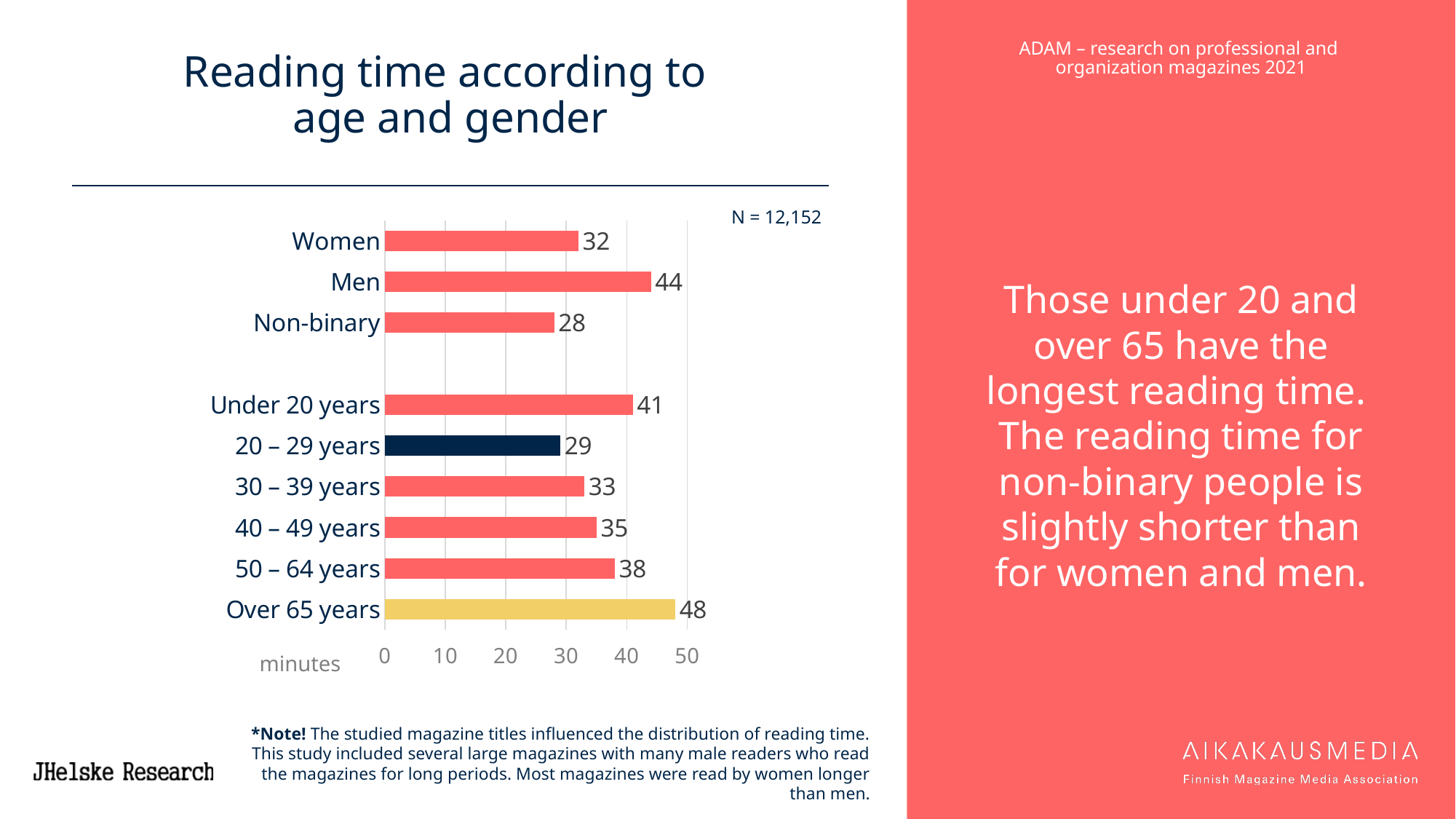
What is the difference in reading time between Men and Women? 12 How many categories are plotted in the chart? 9 What kind of chart is shown on the slide? Bar chart What is the sample size (N) shown next to the chart? N = 12,152 Which category has the lowest reading time? Non-binary Which category has the highest reading time? Over 65 years Which has a longer reading time, Under 20 years or 40 – 49 years? Under 20 years Is the reading time for 30 – 39 years greater or less than 30? greater What is the reading time in minutes for Men? 44 What is the difference in reading time between Over 65 years and 20 – 29 years? 19 What is the reading time in minutes for Non-binary readers? 28 What is the reading time in minutes for the 50 – 64 years group? 38